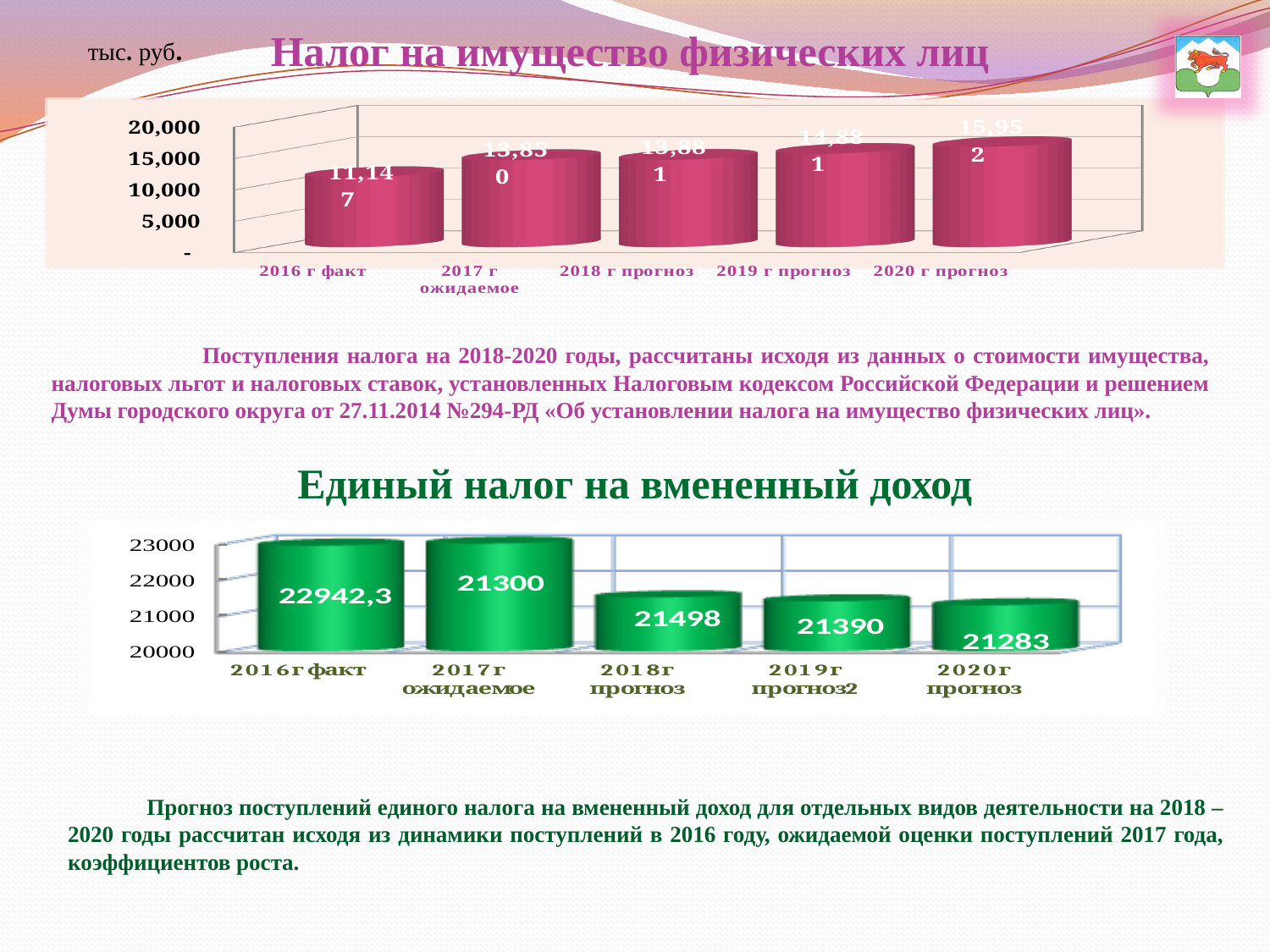
On the chart 'Единый налог на вмененный доход', which is larger: the value for 2017г ожидаемое or the value for 2018г прогноз? 2018г прогноз On the chart 'Единый налог на вмененный доход', how many categories are shown? 5 On the chart 'Единый налог на вмененный доход', what is the value for 2016г факт? 22942,3 On the chart 'Единый налог на вмененный доход', which category has the lowest value? 2020г прогноз On the chart 'Налог на имущество физических лиц', is the value for 2016 г факт greater or less than 15,000? less On the chart 'Налог на имущество физических лиц', do the values rise or fall from 2016 г факт to 2020 г прогноз? rise On the chart 'Единый налог на вмененный доход', what is the difference between the values for 2018г прогноз and 2019г прогноз2? 108 What kind of chart is 'Налог на имущество физических лиц'? bar chart On the chart 'Единый налог на вмененный доход', what is the value for 2020г прогноз? 21283 On the chart 'Налог на имущество физических лиц', which category has the highest value? 2020 г прогноз On the chart 'Единый налог на вмененный доход', what is the value for 2018г прогноз? 21498 On the chart 'Единый налог на вмененный доход', which category has the highest value? 2016г факт